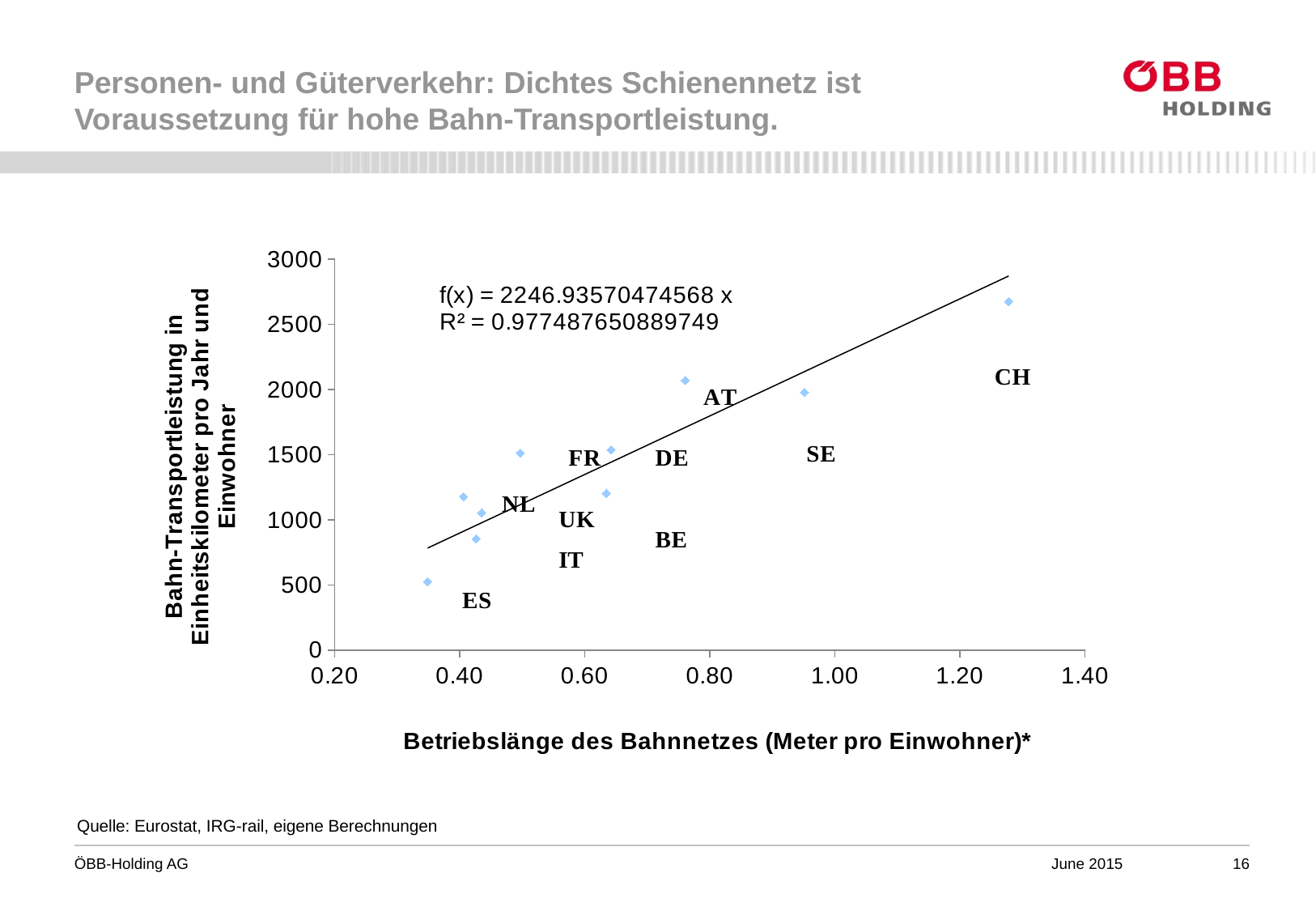
What kind of chart is shown on the slide? scatter chart How many country data points are plotted in the chart? 10 Do the plotted values generally rise or fall as Betriebslänge des Bahnnetzes increases? rise What is the title of the x axis of the chart? Betriebslänge des Bahnnetzes (Meter pro Einwohner)* Which country has the lowest Bahn-Transportleistung in the chart? ES Is the Bahn-Transportleistung value for CH greater or less than 2500? greater What R² value is printed on the chart? 0.977487650889749 Is the Betriebslänge value for CH greater or less than 1.20? greater Is the Bahn-Transportleistung value for ES greater or less than 1000? less Which has a higher Bahn-Transportleistung, AT or ES? AT Which country has the highest Bahn-Transportleistung in the chart? CH